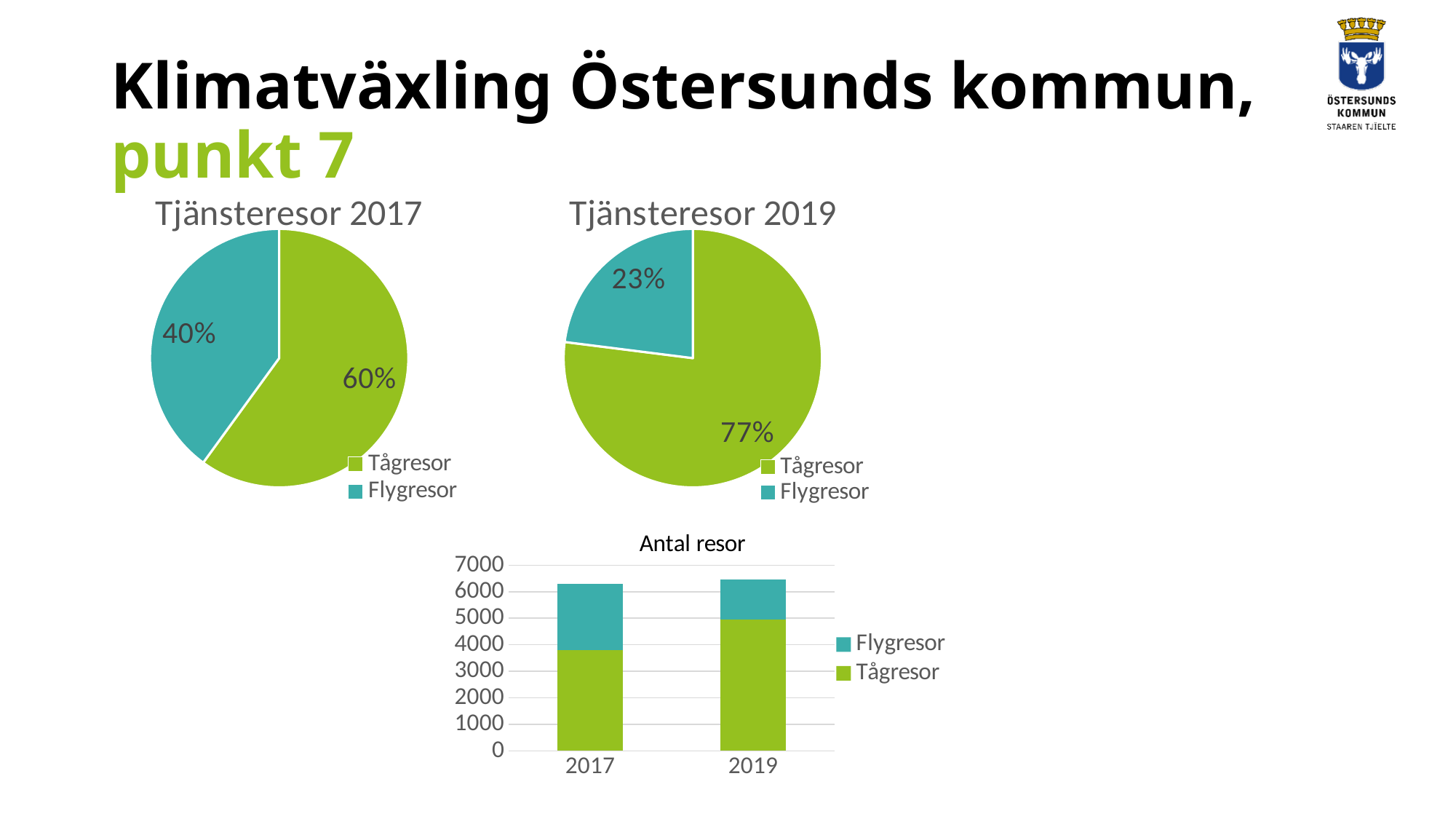
In the Antal resor chart, is the Tågresor value for 2019 greater or less than 4000? greater In the Tjänsteresor 2017 pie chart, which slice is the smallest? Flygresor In the Tjänsteresor 2019 pie chart, which slice is the largest? Tågresor In the Tjänsteresor 2019 pie chart, what share is Tågresor? 77% What kind of chart is the Antal resor chart at the bottom of the slide? Stacked bar chart How many series does the legend of the Antal resor chart list? 2 In the Antal resor chart, is the Tågresor value for 2017 greater or less than 3000? greater In the Tjänsteresor 2017 pie chart, what is the difference in percentage points between Tågresor and Flygresor? 20 percentage points In the Tjänsteresor 2017 pie chart, what share is Flygresor? 40% In the Tjänsteresor 2017 pie chart, what share is Tågresor? 60% In the Antal resor chart, which year has the larger Tågresor value, 2017 or 2019? 2019 In the Tjänsteresor 2019 pie chart, what share is Flygresor? 23%